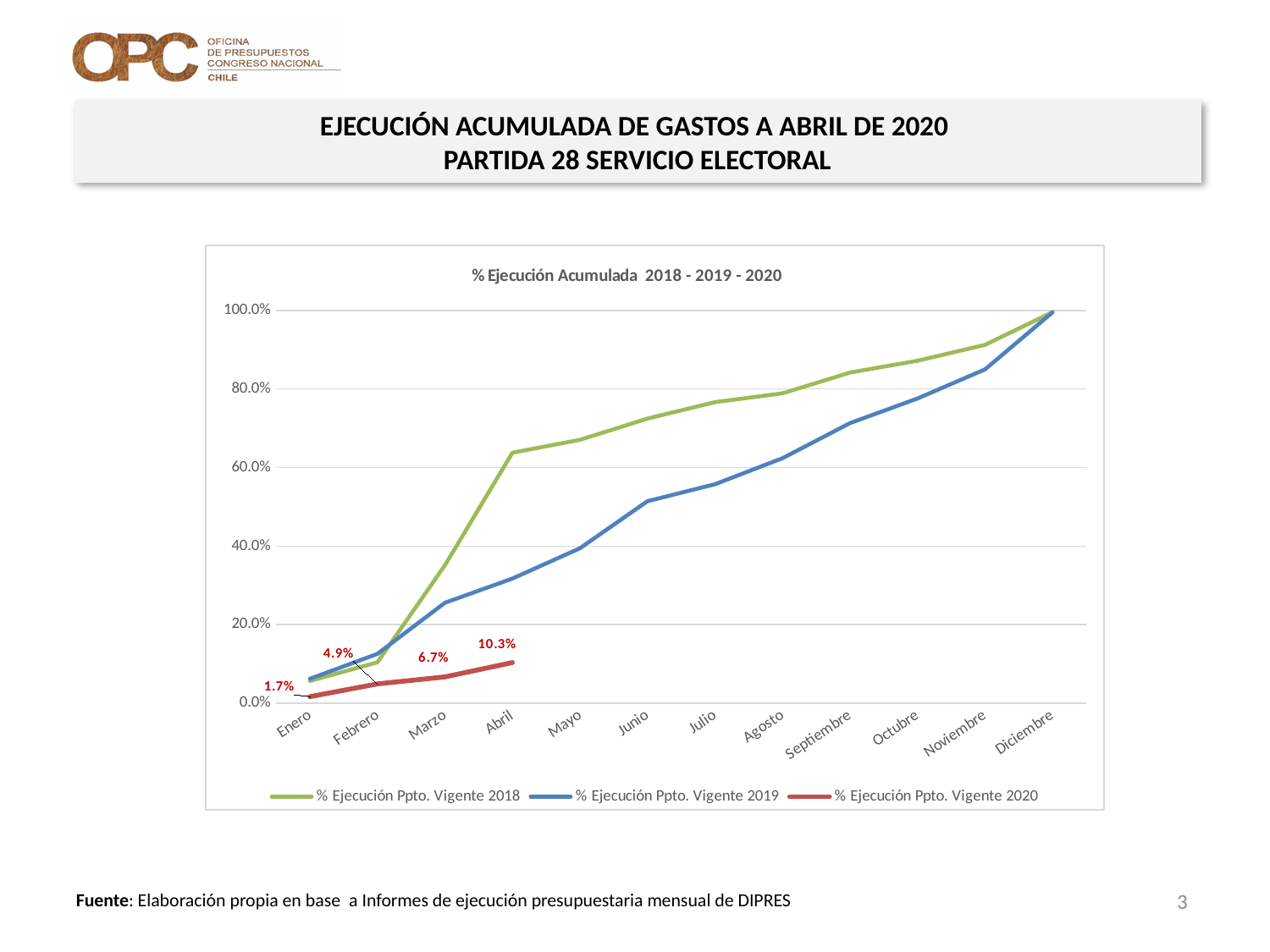
In Abril, which is larger: % Ejecución Ppto. Vigente 2018 or % Ejecución Ppto. Vigente 2019? % Ejecución Ppto. Vigente 2018 What is the value of % Ejecución Ppto. Vigente 2020 in Marzo? 6.7% What type of chart is shown on the slide? Line chart Does the % Ejecución Ppto. Vigente 2020 line rise or fall from Enero to Abril? Rise What is the difference between the 2020 values for Abril and Enero? 8.6% What is the value of % Ejecución Ppto. Vigente 2020 in Abril? 10.3% What is the value of % Ejecución Ppto. Vigente 2020 in Enero? 1.7% Is the value for % Ejecución Ppto. Vigente 2018 in Abril greater or less than 60.0%? greater What is the title of the chart? % Ejecución Acumulada 2018 - 2019 - 2020 What is the difference between the 2020 values for Abril and Marzo? 3.6% How many months are shown on the x axis? 12 How many series does the legend list? 3